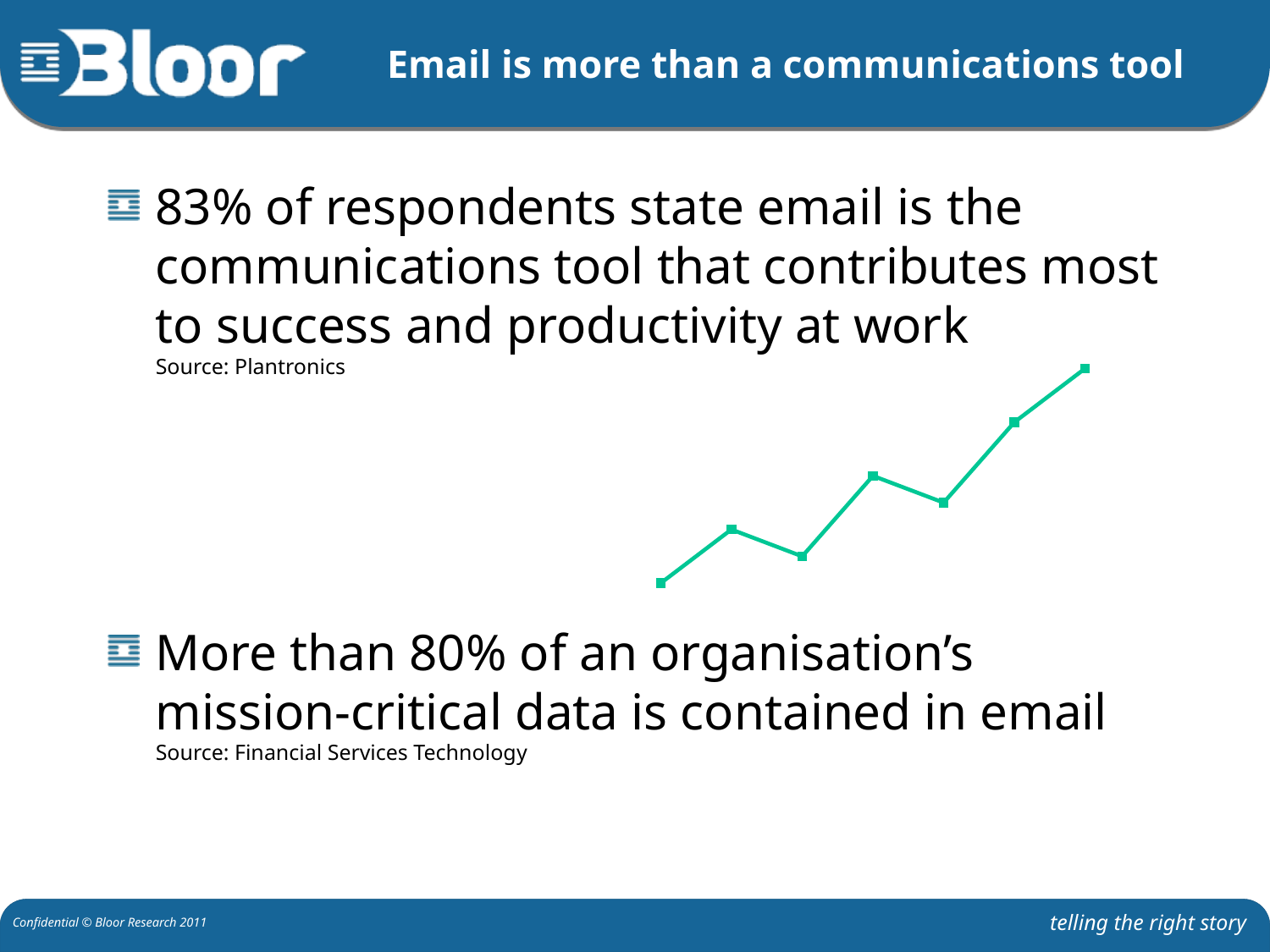
Which point on the line chart is the highest, the leftmost or the rightmost? rightmost What kind of chart is shown on the slide? line chart Which point on the line chart is the lowest, the leftmost or the rightmost? leftmost Do the values on the line chart generally rise or fall from left to right? rise What colour is the line on the chart? green Does the line chart show any axis labels or data values? No Is the second point on the line chart higher or lower than the third point? higher How many data points are plotted on the line chart? 7 Is the fourth point on the line chart higher or lower than the fifth point? higher